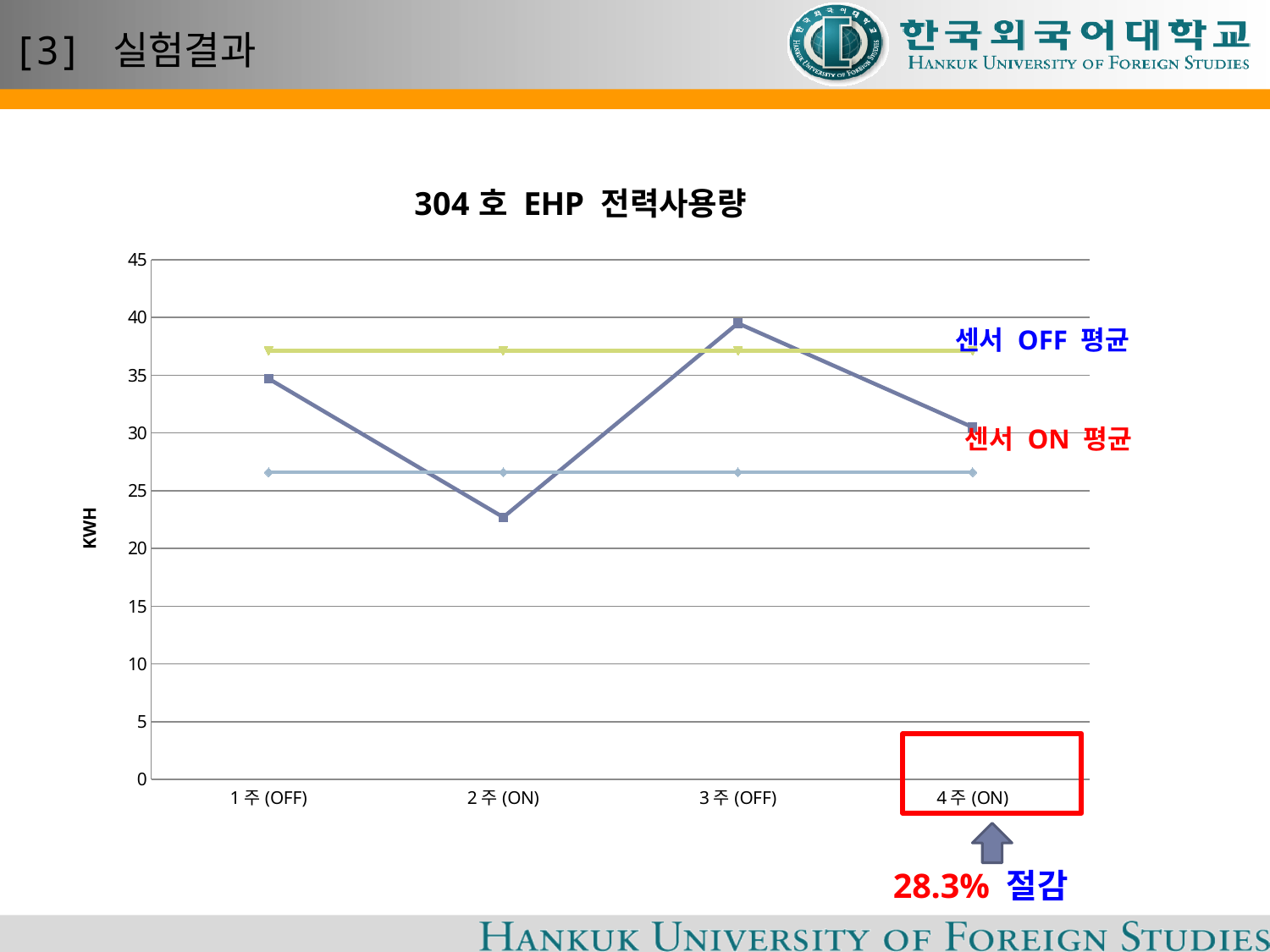
Is the value for 4주 (ON) greater or less than 35? less What is the title of the chart? 304 호 EHP 전력사용량 Which is larger, the value for 1주 (OFF) or the value for 4주 (ON)? 1주 (OFF) Which week has the highest EHP power usage? 3주 (OFF) Which average line is higher, 센서 OFF 평균 or 센서 ON 평균? 센서 OFF 평균 Is the value for 2주 (ON) greater or less than 25? less Which week has the lowest EHP power usage? 2주 (ON) How many week categories are shown on the x axis? 4 What kind of chart is shown on the slide? line chart Does the power usage rise or fall from 1주 (OFF) to 2주 (ON)? fall Is the value for 3주 (OFF) greater or less than 35? greater